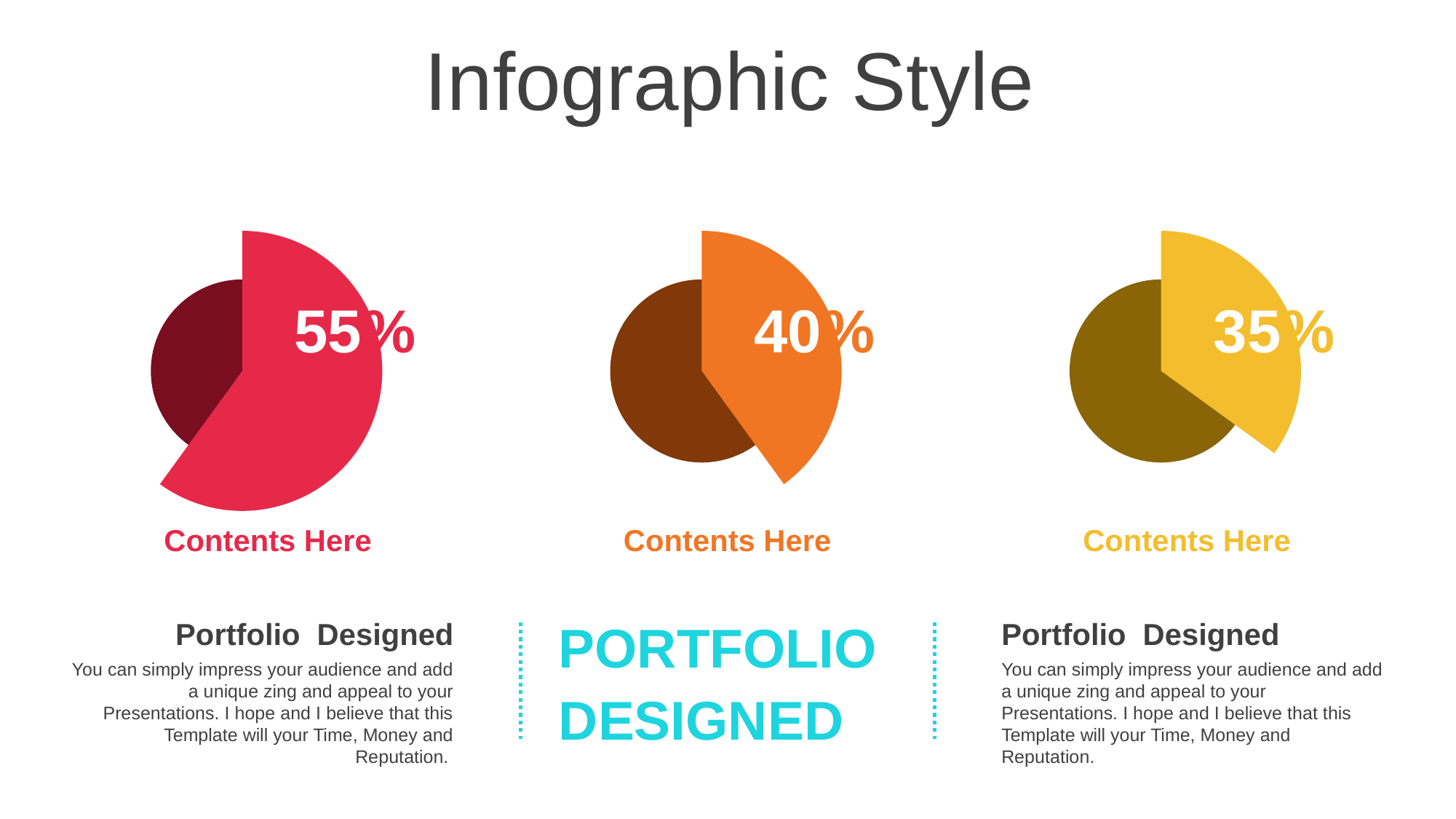
What kind of chart is used for each of the three figures on the slide? Pie chart What percentage is shown on the right (yellow) pie chart? 35% Is the percentage on the middle pie chart larger or smaller than the percentage on the right pie chart? Larger What is the difference between the percentage on the left pie chart and the percentage on the right pie chart? 20% Which of the three pie charts shows the lowest percentage? The right (yellow) chart, 35% What percentage is shown on the left (red) pie chart? 55% What label appears beneath each of the three pie charts? Contents Here What is the difference between the percentage on the left pie chart and the percentage on the middle pie chart? 15% What is the title of the slide? Infographic Style What percentage is shown on the middle (orange) pie chart? 40% How many pie charts are shown on the slide? 3 Which of the three pie charts shows the highest percentage? The left (red) chart, 55%